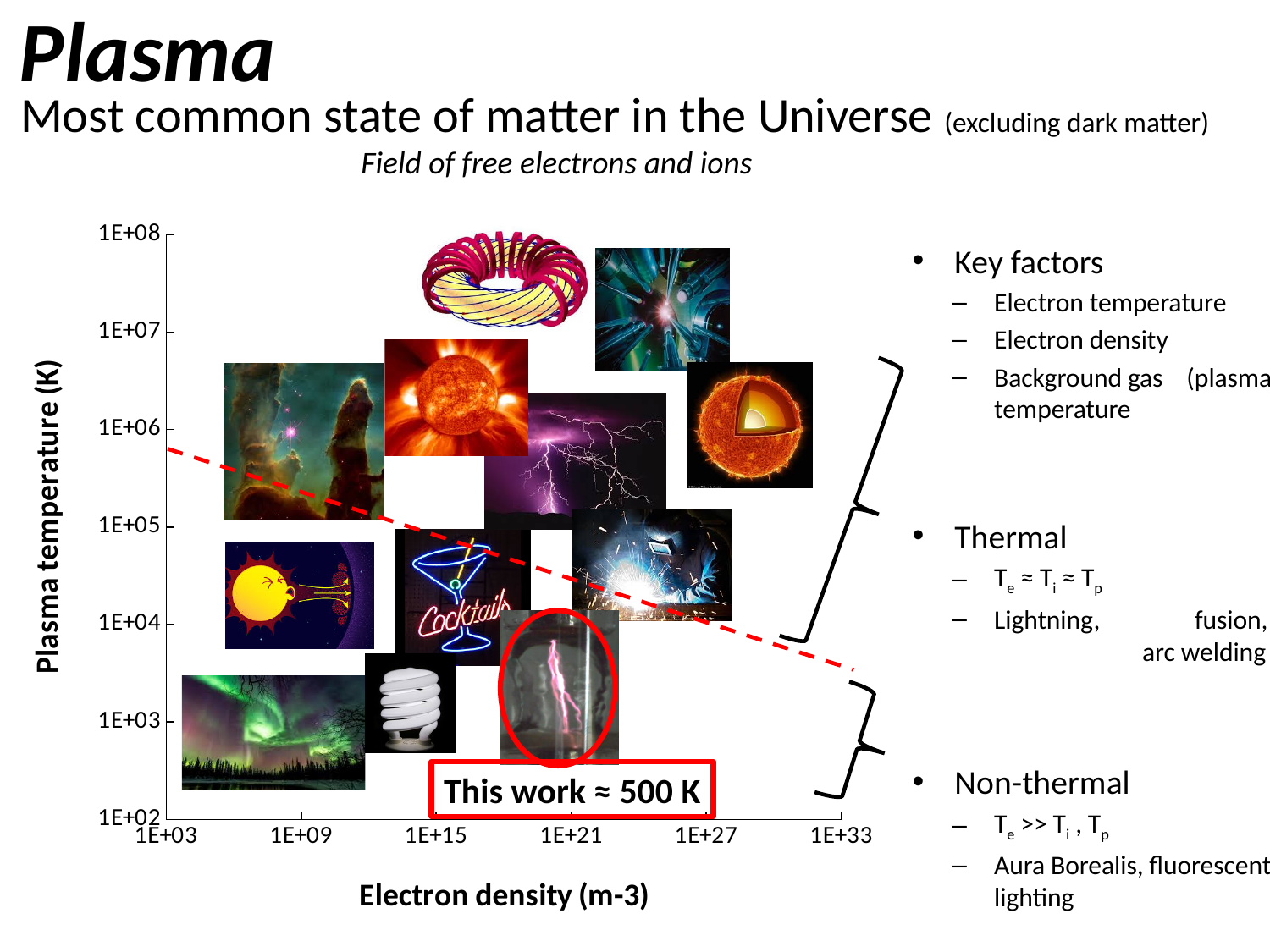
Is the plasma temperature given for 'This work' greater or less than 1E+03 K? less What plasma temperature does the chart's label give for 'This work'? ≈ 500 K What is the lowest tick value shown on the x axis of the chart? 1E+03 What is the label on the y axis of the chart? Plasma temperature (K) What is the highest tick value shown on the y axis of the chart? 1E+08 What is the highest tick value shown on the x axis of the chart? 1E+33 How many tick labels are shown on the y axis of the chart? 7 What is the label on the x axis of the chart? Electron density (m-3) Does the red dashed line on the chart rise or fall as electron density increases? fall What is the lowest tick value shown on the y axis of the chart? 1E+02 How many tick labels are shown on the x axis of the chart? 6